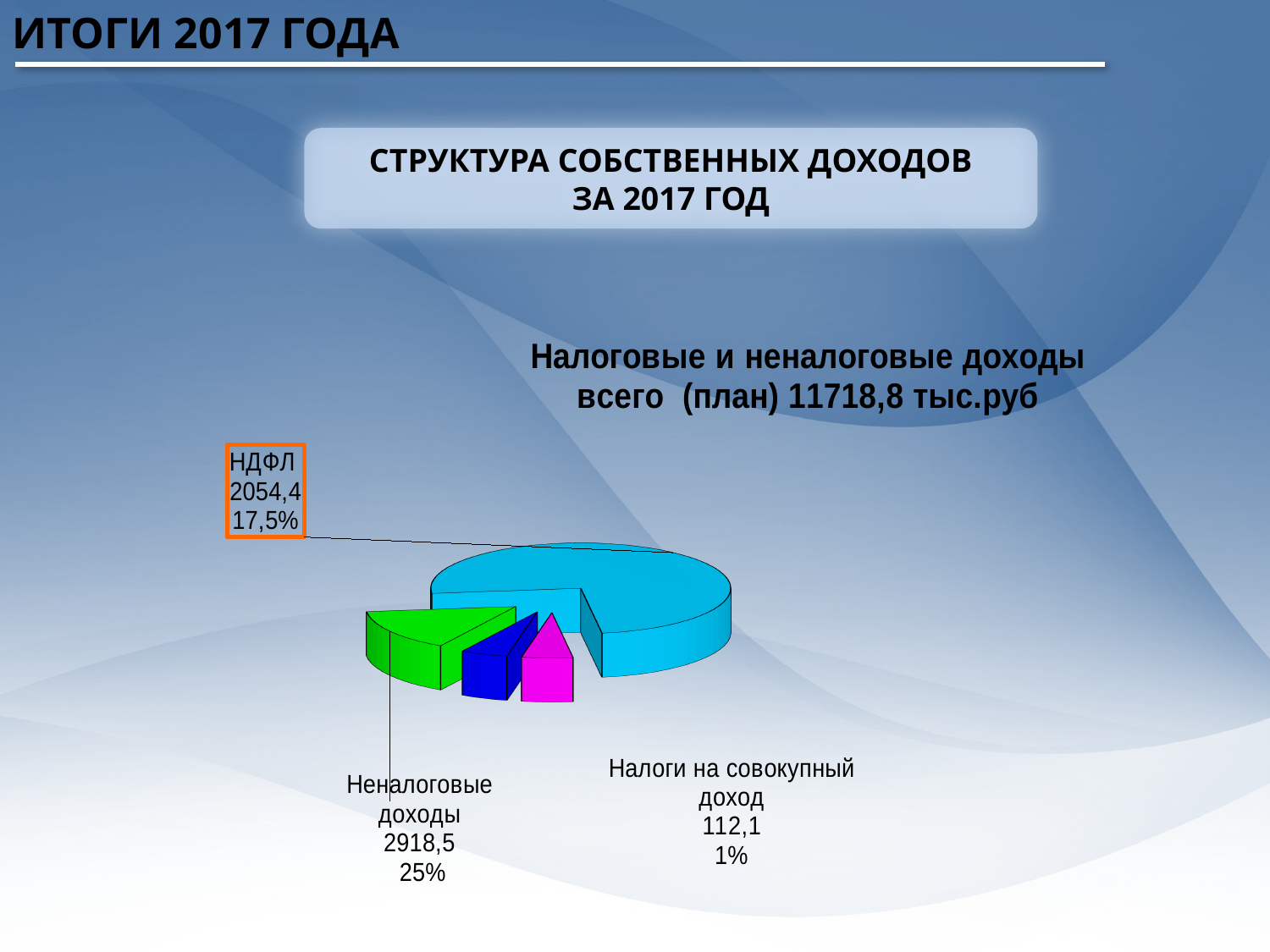
Which of the labeled categories on the pie chart has the smallest value? Налоги на совокупный доход What value is shown for Неналоговые доходы on the pie chart? 2918,5 Which is larger on the pie chart, Неналоговые доходы or НДФЛ? Неналоговые доходы What share of the pie does Неналоговые доходы represent? 25% What value is shown for НДФЛ on the pie chart? 2054,4 What total planned amount of tax and non-tax revenues is stated above the pie chart? 11718,8 тыс.руб What value is shown for Налоги на совокупный доход on the pie chart? 112,1 What share of the pie does Налоги на совокупный доход represent? 1% What is the difference between the values for Неналоговые доходы and НДФЛ on the pie chart? 864,1 What type of chart is shown on the slide? Pie chart What share of the pie does НДФЛ represent? 17,5% What colour is the slice labeled Неналоговые доходы on the pie chart? Green